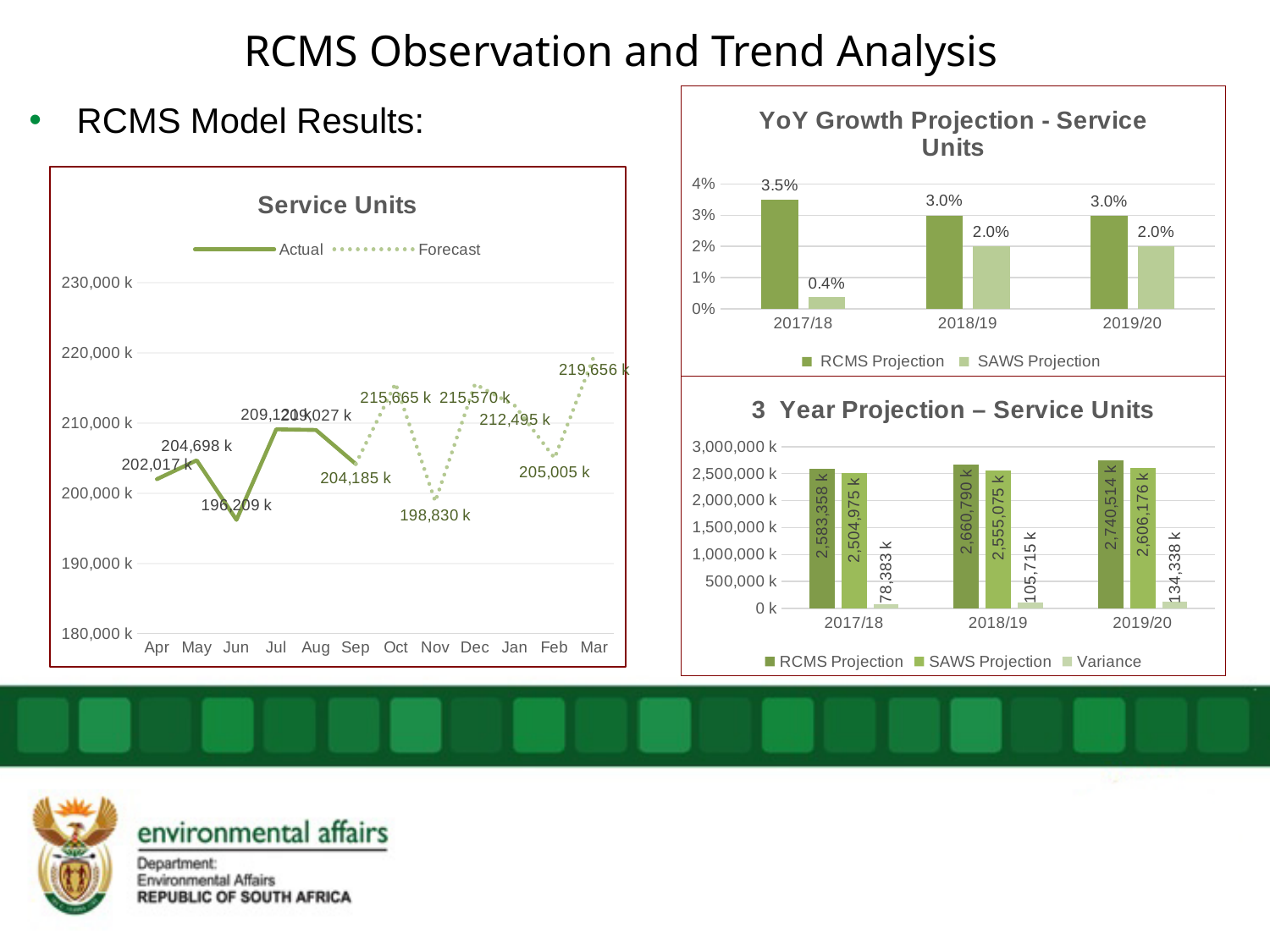
In the 3 Year Projection – Service Units chart, how many series does the legend list? 3 In the YoY Growth Projection - Service Units chart, how many series does the legend list? 2 In the 3 Year Projection – Service Units chart, what is the Variance value for 2018/19? 105,715 k In the Service Units line chart, what is the value for Mar? 219,656 k In the Service Units line chart, which month has the lowest value? Jun In the 3 Year Projection – Service Units chart, which year has the highest Variance? 2019/20 In the Service Units line chart, what is the value for Jun? 196,209 k In the YoY Growth Projection - Service Units chart, what is the difference between the RCMS Projection and the SAWS Projection for 2018/19? 1.0% In the YoY Growth Projection - Service Units chart, what is the RCMS Projection value for 2017/18? 3.5% In the 3 Year Projection – Service Units chart, what is the RCMS Projection value for 2019/20? 2,740,514 k What kind of chart is the 3 Year Projection – Service Units chart? Bar chart In the YoY Growth Projection - Service Units chart, what is the SAWS Projection value for 2017/18? 0.4%